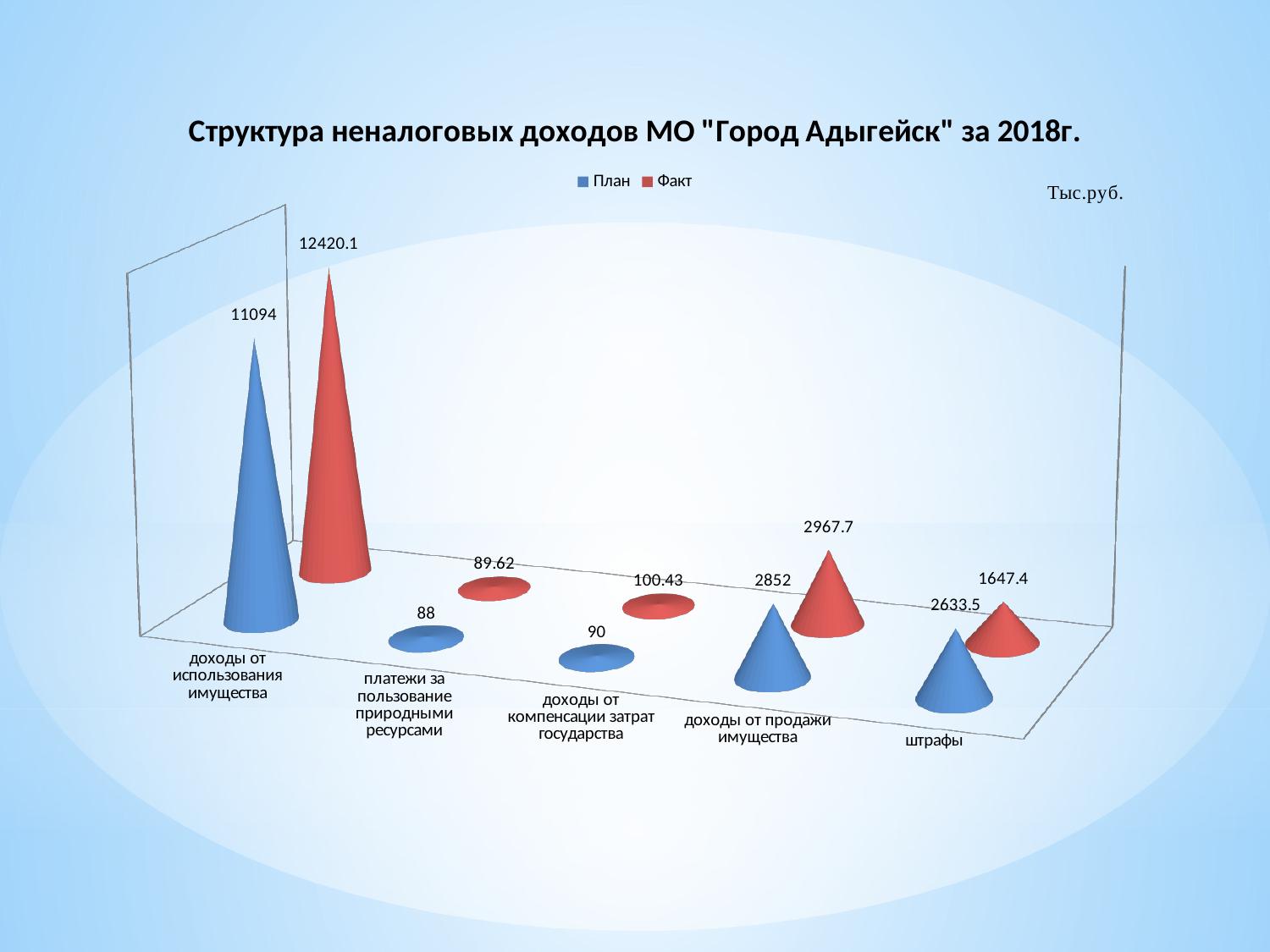
How many categories are shown on the x axis? 5 Which category has the highest Факт value? доходы от использования имущества For штрафы, which is larger: the План value or the Факт value? План Which category has the lowest План value? платежи за пользование природными ресурсами What is the Факт value for доходы от использования имущества? 12420.1 What is the difference between the Факт and План values for доходы от использования имущества? 1326.1 What is the План value for доходы от использования имущества? 11094 For доходы от продажи имущества, which is larger: the План value or the Факт value? Факт What is the Факт value for штрафы? 1647.4 What unit of measurement is indicated on the chart? Тыс.руб. What is the План value for доходы от продажи имущества? 2852 How many series does the legend list? 2